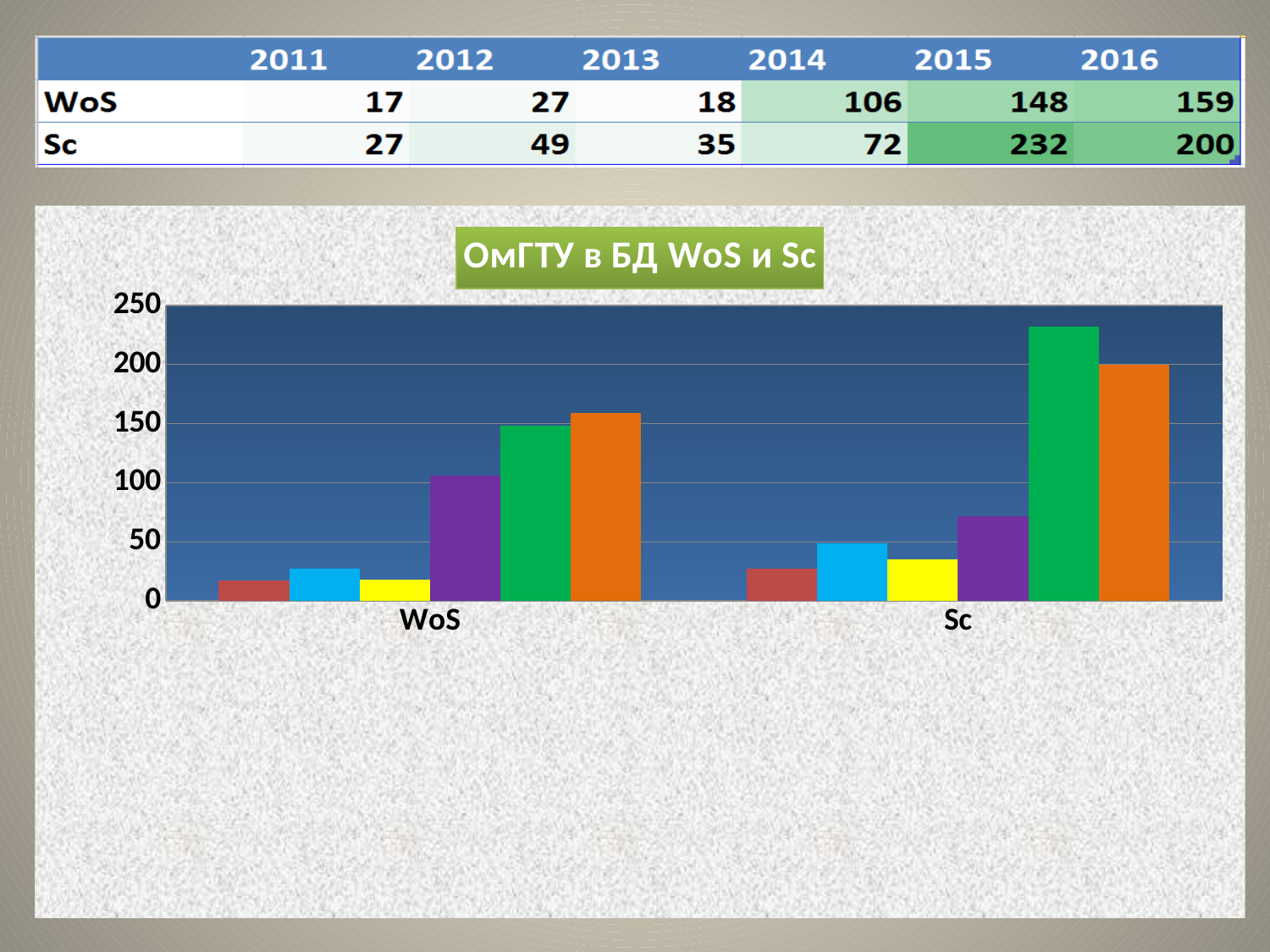
Is the red (first) bar in the WoS group greater or less than 50? less Which is larger: the orange bar in the WoS group or the orange bar in the Sc group? the orange bar in the Sc group Which category, WoS or Sc, contains the tallest bar in the chart? Sc Is the purple bar in the Sc group greater or less than 100? less Using the table above the chart, what is the difference between the Sc and WoS values for 2015? 84 Is the tallest bar in the Sc group greater or less than 200? greater According to the table above the chart, what is the Sc value for 2015? 232 What is the title of the chart? ОмГТУ в БД WoS и Sc How many categories are labelled on the x axis of the chart? 2 How many bars are plotted in the WoS group of the chart? 6 What kind of chart is shown on the slide? bar chart According to the table above the chart, what is the WoS value for 2016? 159